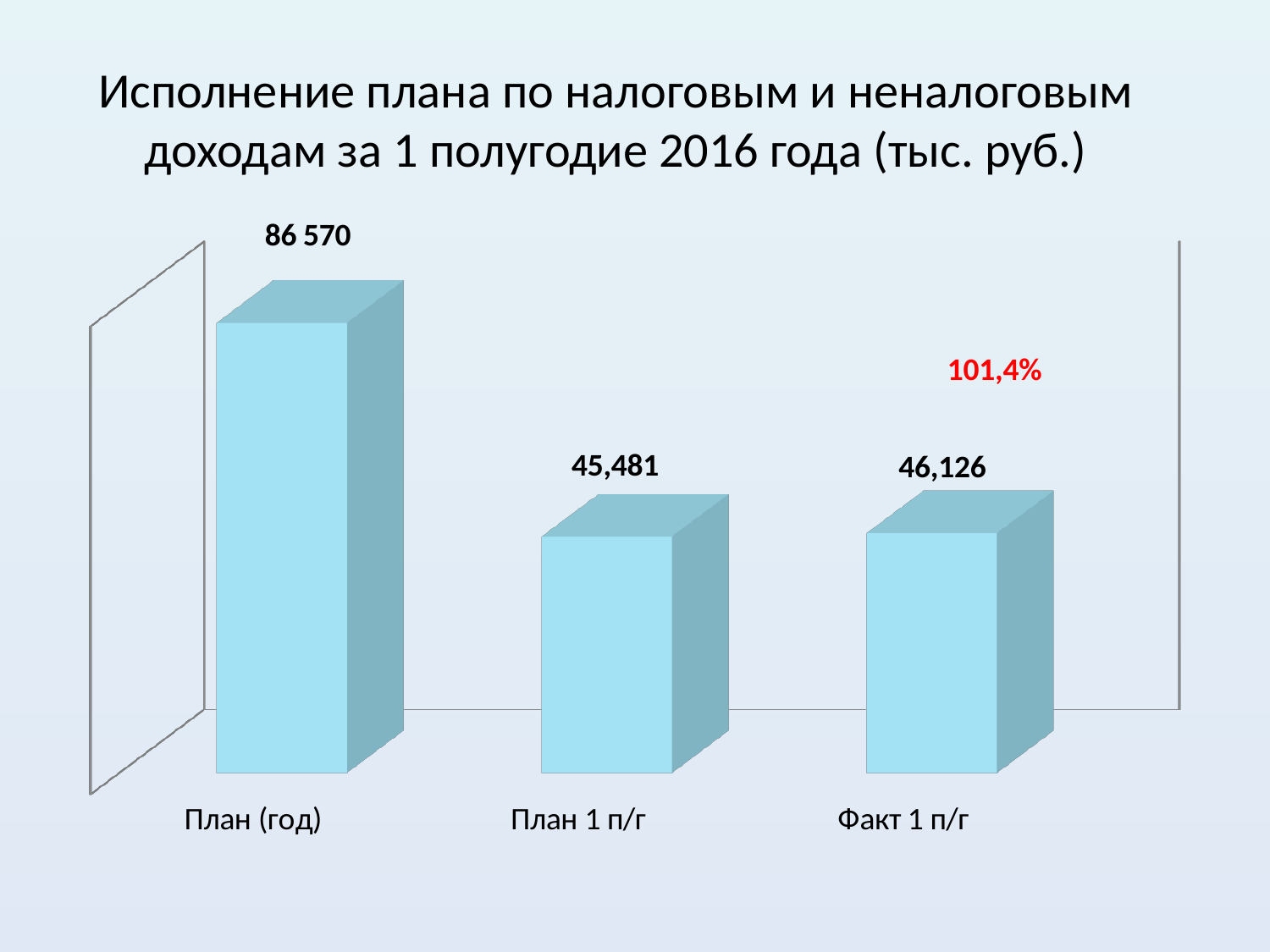
Which category has the highest value? План (год) What unit is given in the chart title? тыс. руб. What is the value for План 1 п/г? 45,481 What is the value for Факт 1 п/г? 46,126 What kind of chart is shown on the slide? Bar chart Which is larger, the value for План 1 п/г or the value for Факт 1 п/г? Факт 1 п/г What is the difference between the values for Факт 1 п/г and План 1 п/г? 645 What percentage is shown in red above the Факт 1 п/г bar? 101,4% What is the value for План (год)? 86 570 Which category has the lowest value? План 1 п/г How many bars are shown in the chart? 3